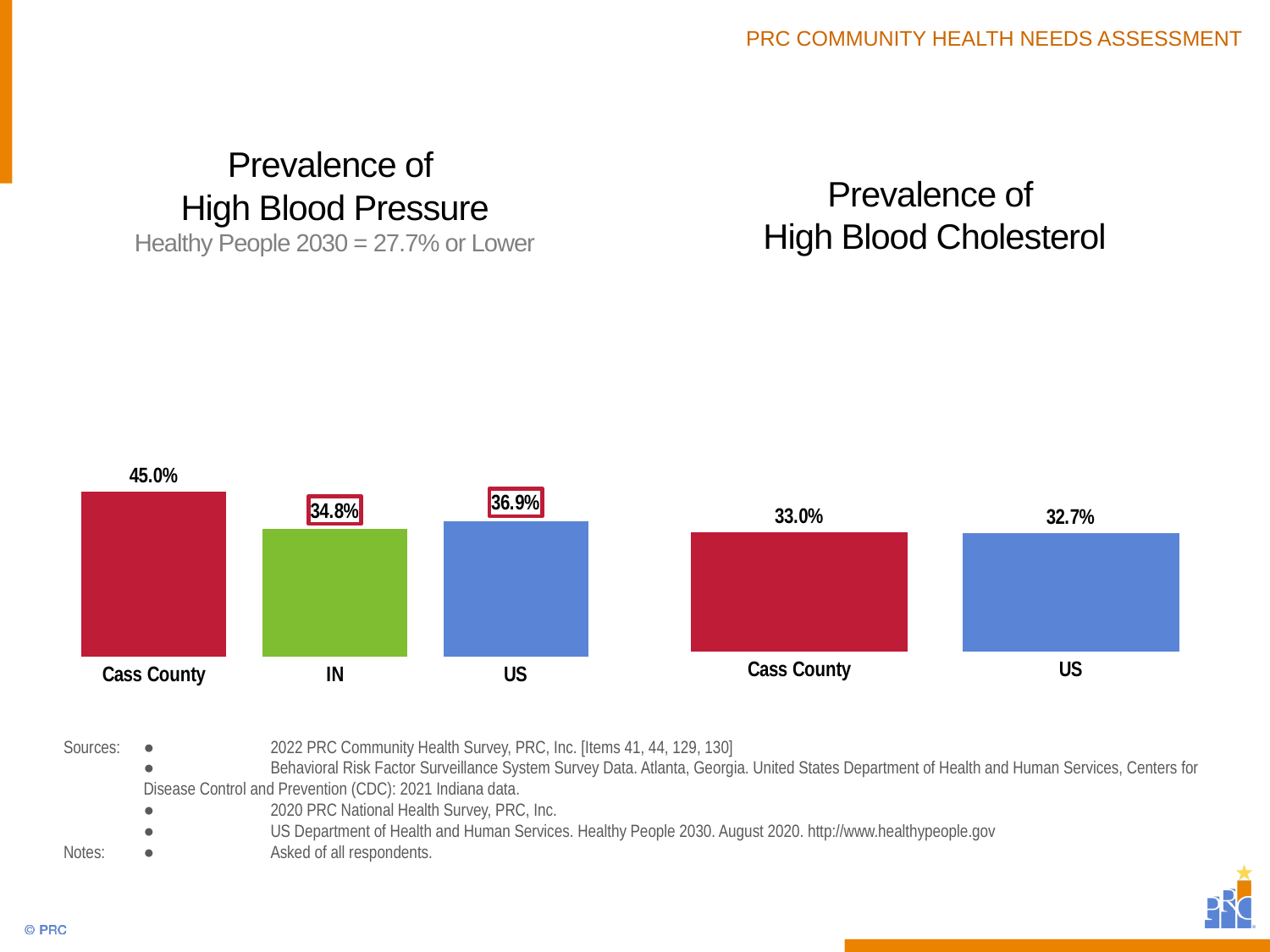
In the Prevalence of High Blood Pressure chart, which category has the lowest value? IN In the Prevalence of High Blood Pressure chart, what is the value for US? 36.9% In the Prevalence of High Blood Pressure chart, which category has the highest value? Cass County In the Prevalence of High Blood Cholesterol chart, what is the value for US? 32.7% In the Prevalence of High Blood Pressure chart, what is the value for IN? 34.8% What Healthy People 2030 target is shown under the Prevalence of High Blood Pressure chart title? 27.7% or Lower In the Prevalence of High Blood Pressure chart, what is the value for Cass County? 45.0% In the Prevalence of High Blood Cholesterol chart, what is the difference between the Cass County value and the US value? 0.3% In the Prevalence of High Blood Pressure chart, what is the difference between the Cass County value and the US value? 8.1% In the Prevalence of High Blood Pressure chart, how many categories are shown? 3 What kind of chart is the Prevalence of High Blood Cholesterol chart? Bar chart In the Prevalence of High Blood Cholesterol chart, what is the value for Cass County? 33.0%